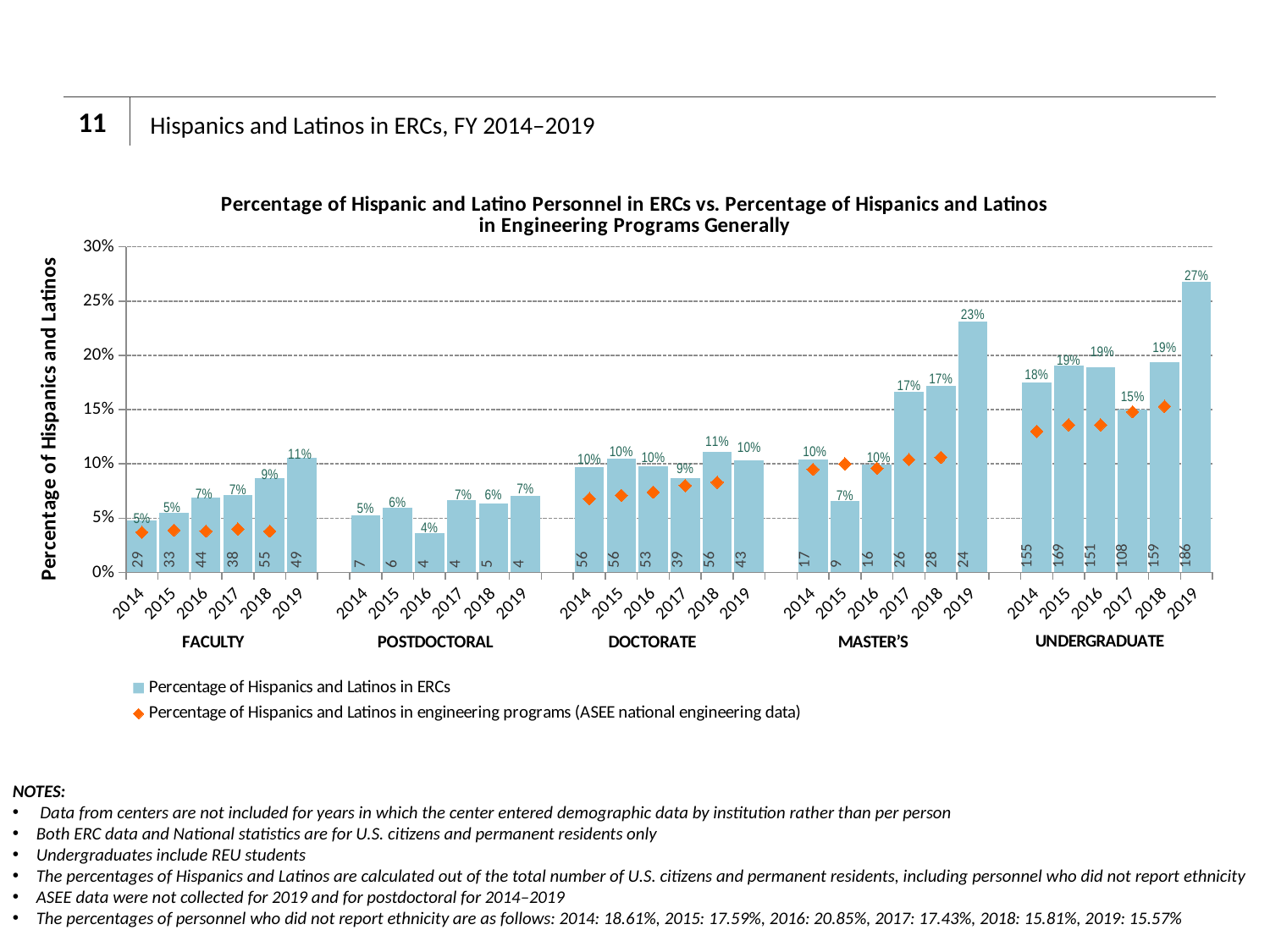
Is the ASEE national engineering value for undergraduates in 2014 greater or less than 10%? greater By how many percentage points did the master's percentage in ERCs change from 2018 to 2019? 6 percentage points Which is larger in 2019: the faculty percentage in ERCs or the doctorate percentage in ERCs? Faculty How many personnel groups are shown along the x axis? 5 Which year has the lowest postdoctoral percentage in ERCs? 2016 What is the percentage of Hispanics and Latinos in ERCs for undergraduates in 2019? 27% What is the percentage of Hispanics and Latinos in ERCs for master's students in 2019? 23% How many series does the legend list? 2 What kind of chart is used to show the percentage of Hispanics and Latinos in ERCs? Bar chart Do the faculty percentages in ERCs generally rise or fall from 2014 to 2019? Rise Which group and year has the highest percentage of Hispanics and Latinos in ERCs? Undergraduate, 2019 What number is printed inside the undergraduate bar for 2019? 186